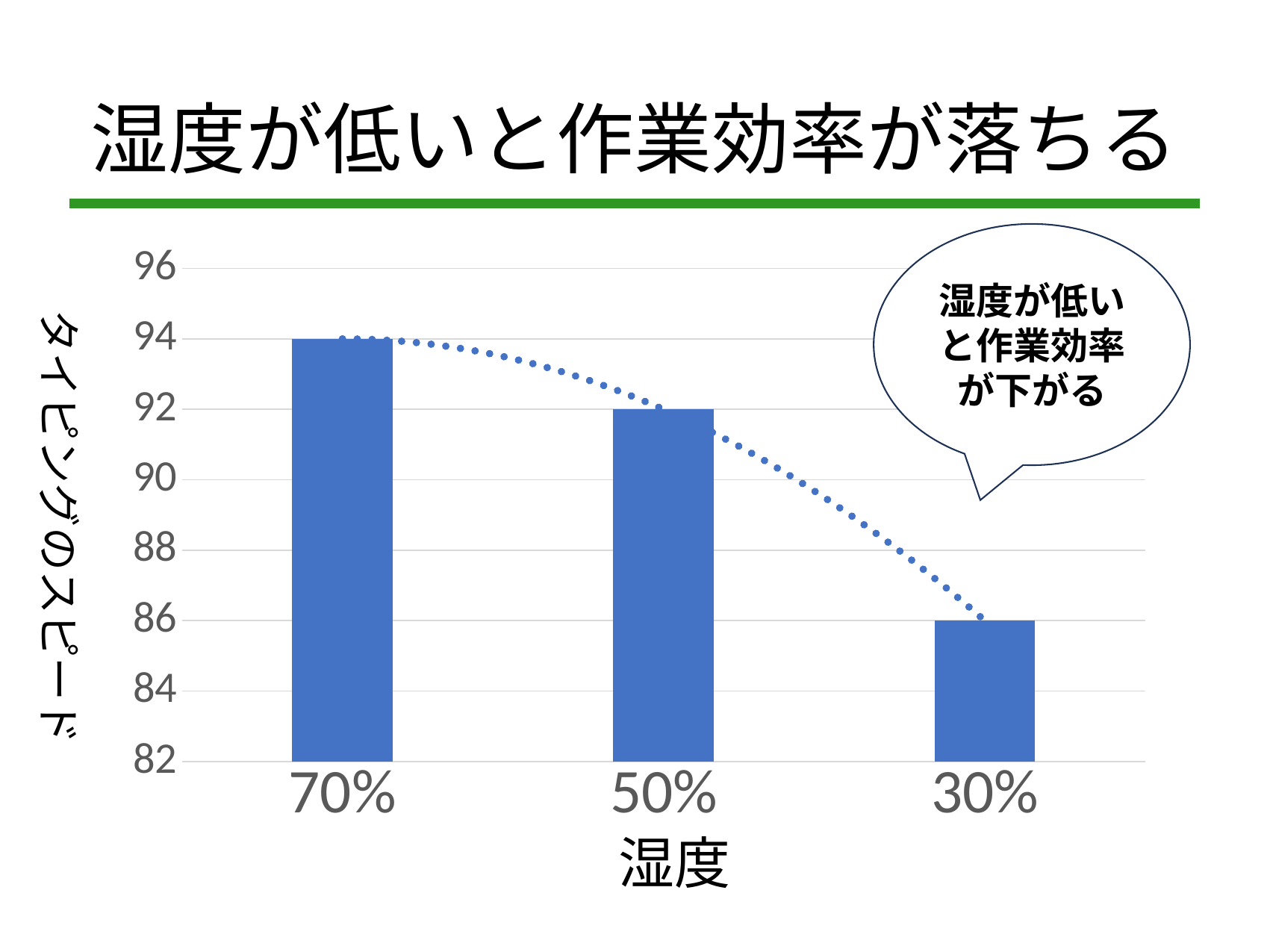
What is the typing speed value for 30% humidity? 86 What is the difference in typing speed between 50% humidity and 30% humidity? 6 What is the difference in typing speed between 70% humidity and 30% humidity? 8 Which humidity level has the lowest typing speed? 30% How many bars (humidity categories) are plotted in the chart? 3 What type of chart is shown on the slide? bar chart What is the typing speed value for 50% humidity? 92 Do the typing speed values rise or fall moving from left to right along the x axis? fall Which has a larger typing speed value, 50% humidity or 30% humidity? 50% What is the typing speed value for 70% humidity? 94 What is the label of the x axis of the chart? 湿度 Which humidity level has the highest typing speed? 70%